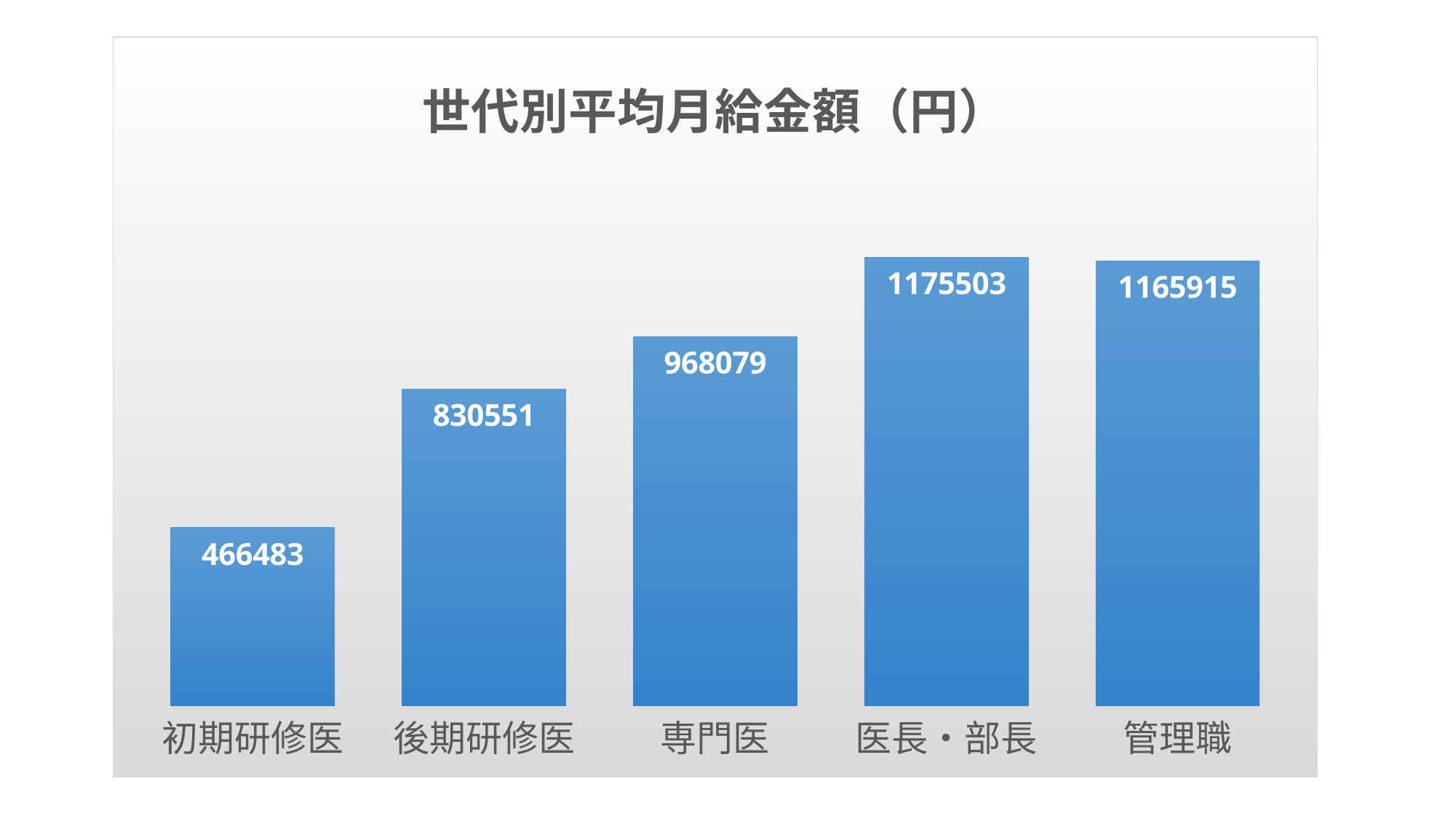
What is the value for 医長・部長? 1175503 Which is larger, the value for 専門医 or the value for 後期研修医? 専門医 What is the value for 管理職? 1165915 What is the value for 専門医? 968079 How many categories are shown in the chart? 5 What is the value for 初期研修医? 466483 Which category has the highest value? 医長・部長 What kind of chart is shown on the slide? Bar chart What is the difference between the values for 医長・部長 and 管理職? 9588 Which category has the lowest value? 初期研修医 What is the value for 後期研修医? 830551 What is the difference between the values for 後期研修医 and 初期研修医? 364068